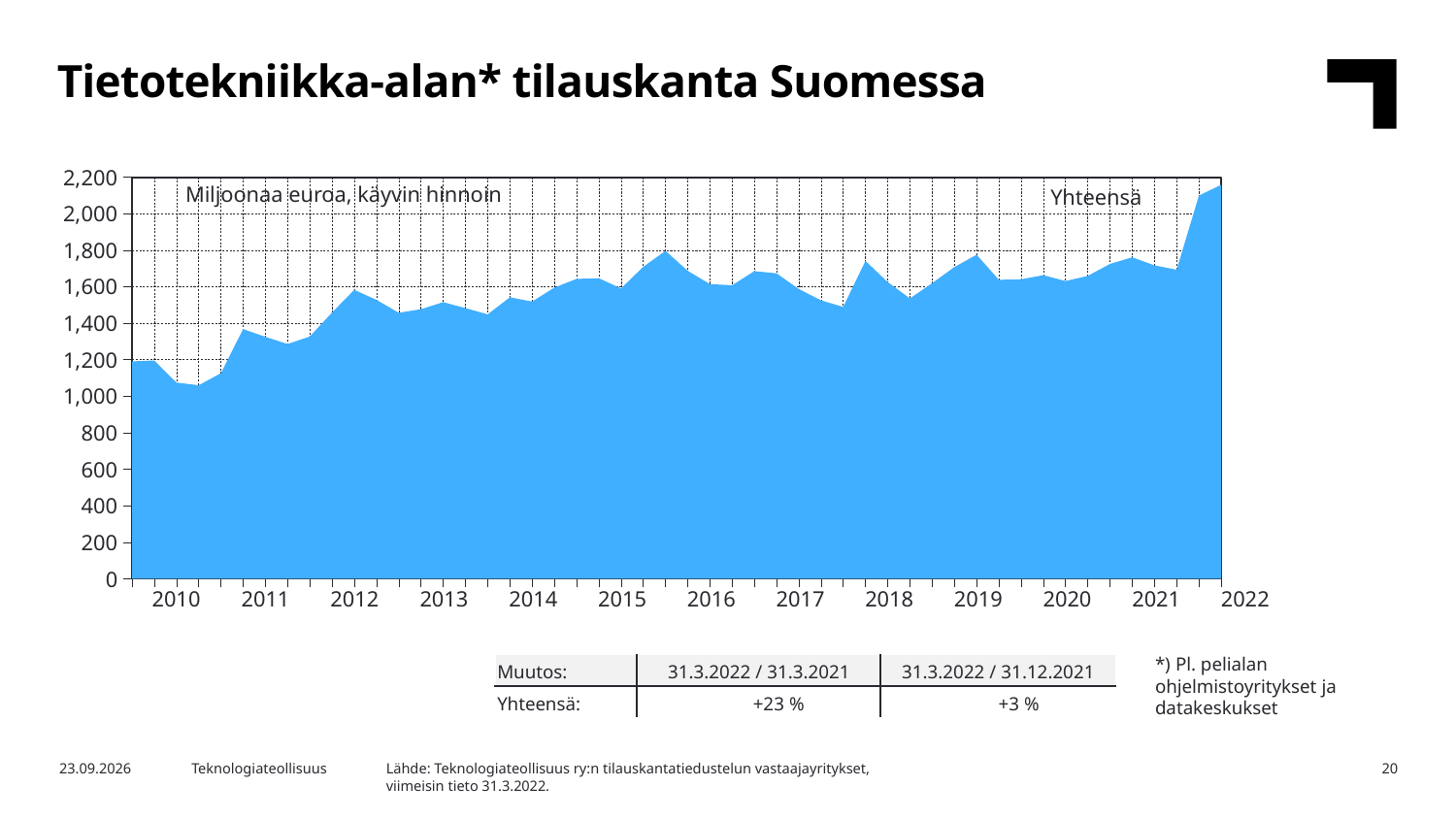
In which year does the series reach its highest value? 2022 Is the value at the start of 2013 greater or less than 1,400? greater Overall, do the values rise or fall from 2010 to 2022? rise How many data series are plotted on the chart? 1 In what unit are the values on the chart expressed, according to the label inside the plot area? Miljoonaa euroa, käyvin hinnoin What kind of chart is shown on the slide? Area chart Is the value at the end of the series in 2022 greater or less than 2,000? greater Is the value at the start of 2010 greater or less than 1,000? greater In which year does the series reach its lowest value? 2010 What is the title of the chart on the slide? Tietotekniikka-alan* tilauskanta Suomessa